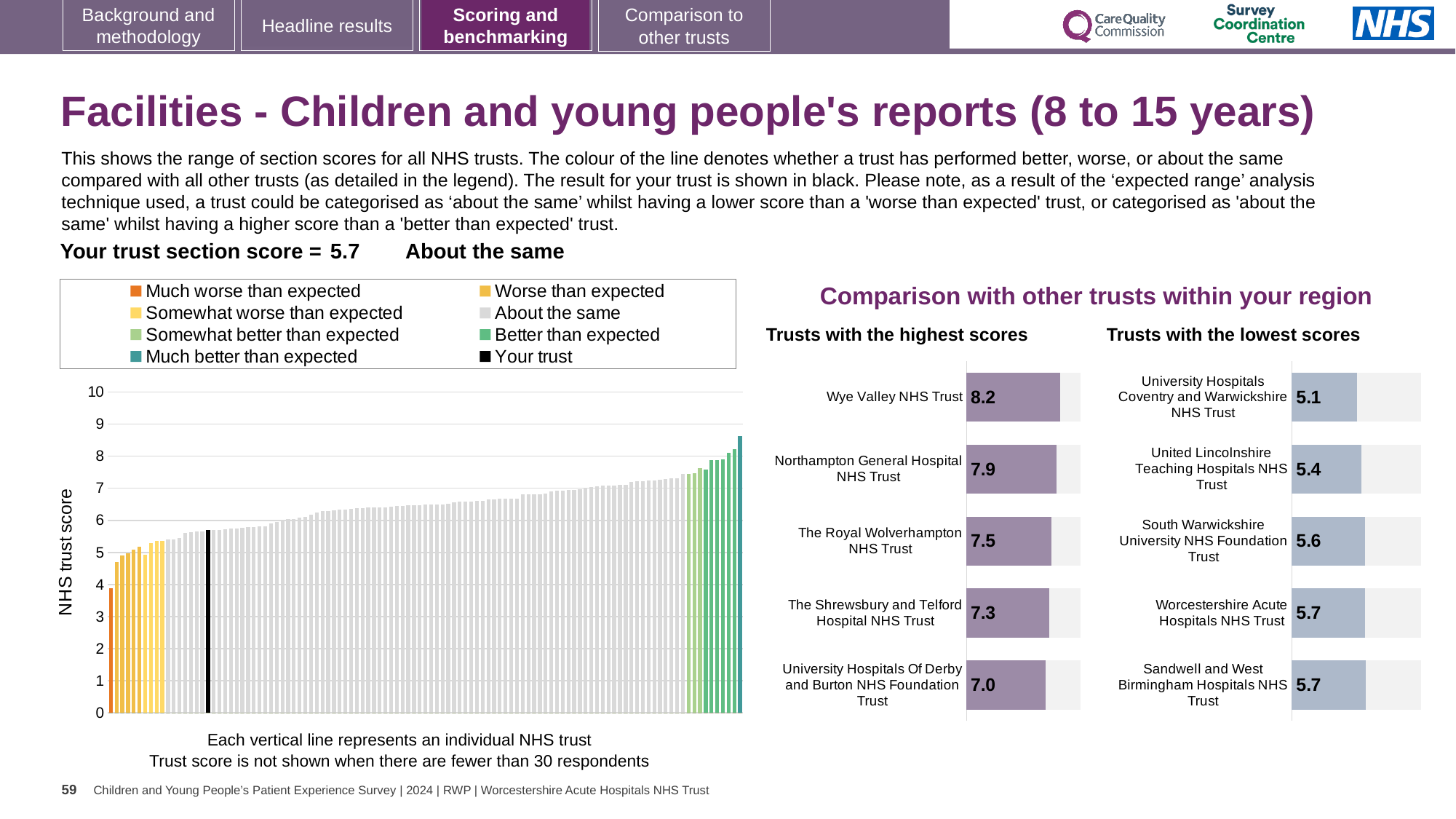
In the 'Trusts with the lowest scores' chart, which trust has the lowest score? University Hospitals Coventry and Warwickshire NHS Trust In the 'Trusts with the highest scores' chart, which trust has the lowest score? University Hospitals Of Derby and Burton NHS Foundation Trust In the 'Trusts with the lowest scores' chart, which has the higher score: United Lincolnshire Teaching Hospitals NHS Trust or Worcestershire Acute Hospitals NHS Trust? Worcestershire Acute Hospitals NHS Trust What kind of chart is the large chart of NHS trust scores on the left? Bar chart How many entries does the legend of the NHS trust score chart list? 8 In the 'Trusts with the highest scores' chart, what is the difference between the scores of Wye Valley NHS Trust and Northampton General Hospital NHS Trust? 0.3 In the large NHS trust score chart, is the value of the tallest bar on the right greater or less than 8? greater In the 'Trusts with the lowest scores' chart, what is the score for University Hospitals Coventry and Warwickshire NHS Trust? 5.1 How many trusts are shown in the 'Trusts with the highest scores' chart? 5 In the 'Trusts with the highest scores' chart, what is the score for Wye Valley NHS Trust? 8.2 In the 'Trusts with the lowest scores' chart, what is the score for South Warwickshire University NHS Foundation Trust? 5.6 In the 'Trusts with the highest scores' chart, what is the score for The Royal Wolverhampton NHS Trust? 7.5